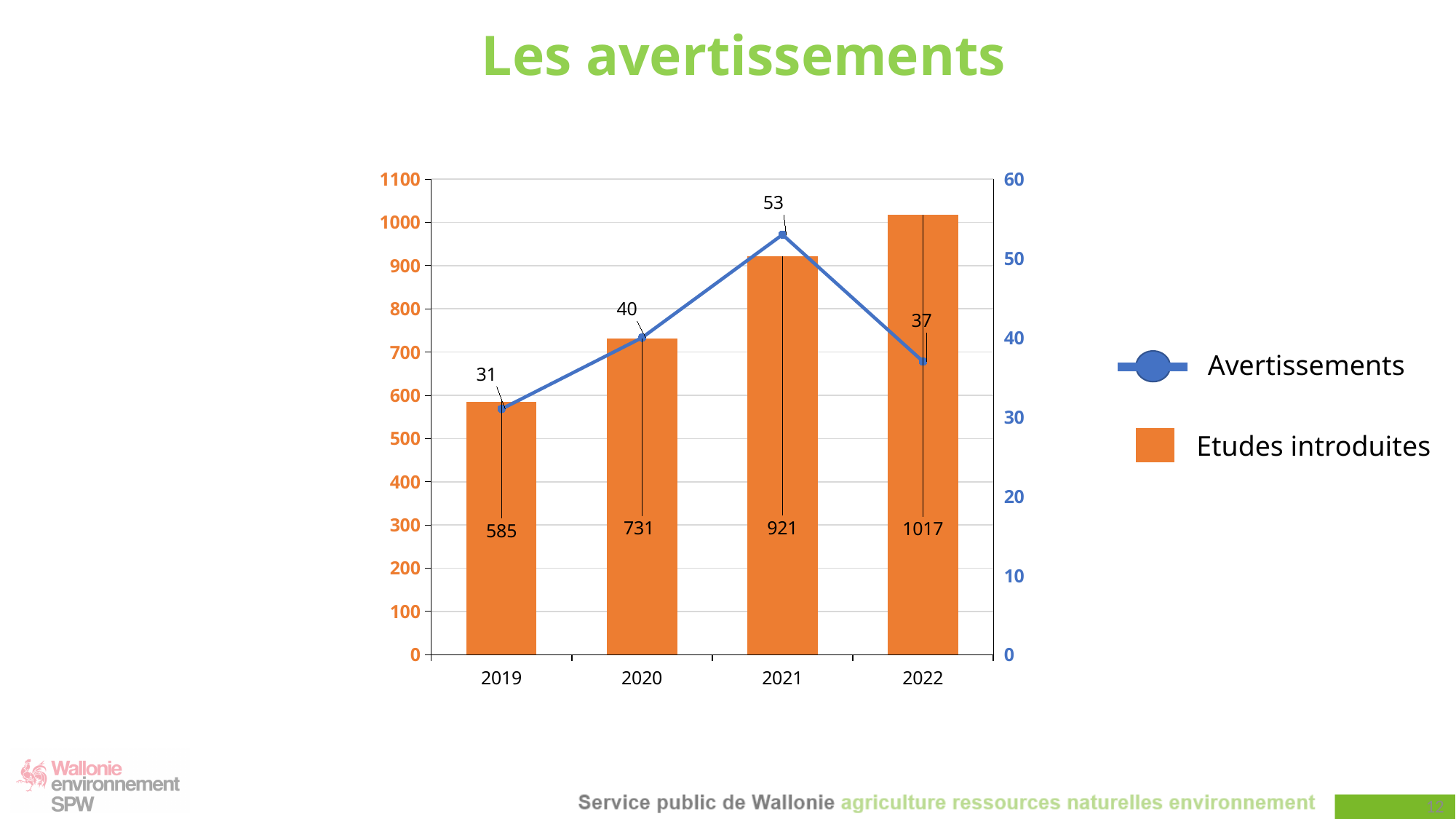
What is the value of Etudes introduites for 2019? 585 What is the value of Avertissements for 2020? 40 What is the difference between Avertissements in 2021 and 2022? 16 Which year has the highest value for Etudes introduites? 2022 What is the value of Avertissements for 2021? 53 How many series does the legend list? 2 Which year has the lowest value for Avertissements? 2019 What is the value of Etudes introduites for 2022? 1017 How many years are shown on the x axis? 4 Which is larger, Avertissements in 2020 or in 2022? 2020 Do the values for Etudes introduites rise or fall from 2019 to 2022? rise What is the difference between Etudes introduites in 2022 and 2021? 96